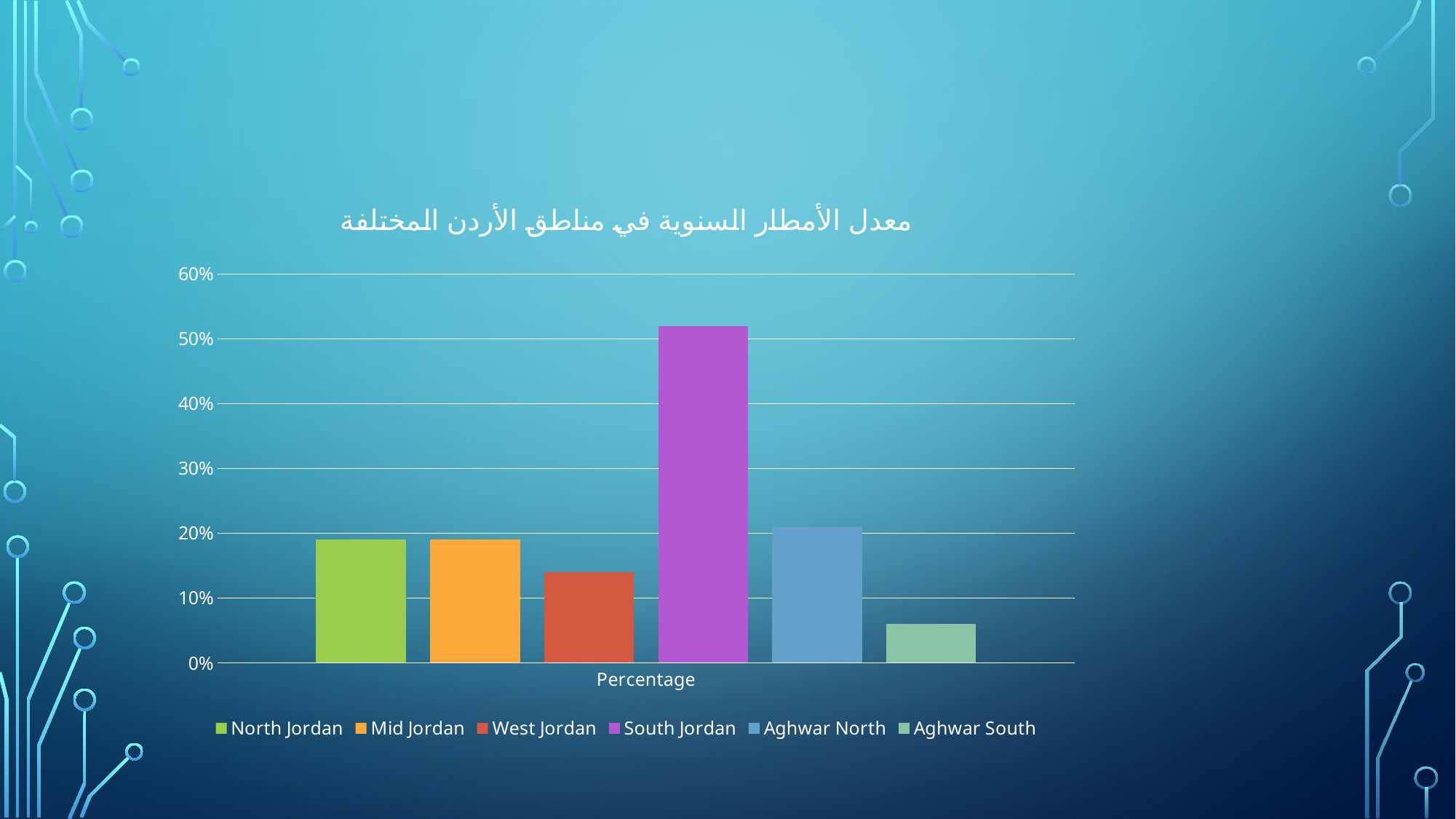
What is the label shown on the x axis below the bars? Percentage Is the value for South Jordan greater or less than 50%? greater What kind of chart is shown on the slide? bar chart Is the value for Aghwar South greater or less than 10%? less Which series has the highest bar? South Jordan Which is larger, the value for Aghwar North or the value for Aghwar South? Aghwar North How many series does the legend list? 6 What colour is the bar for South Jordan? purple Is the value for Aghwar North greater or less than 30%? less Which is larger, the value for South Jordan or the value for West Jordan? South Jordan Which series has the lowest bar? Aghwar South